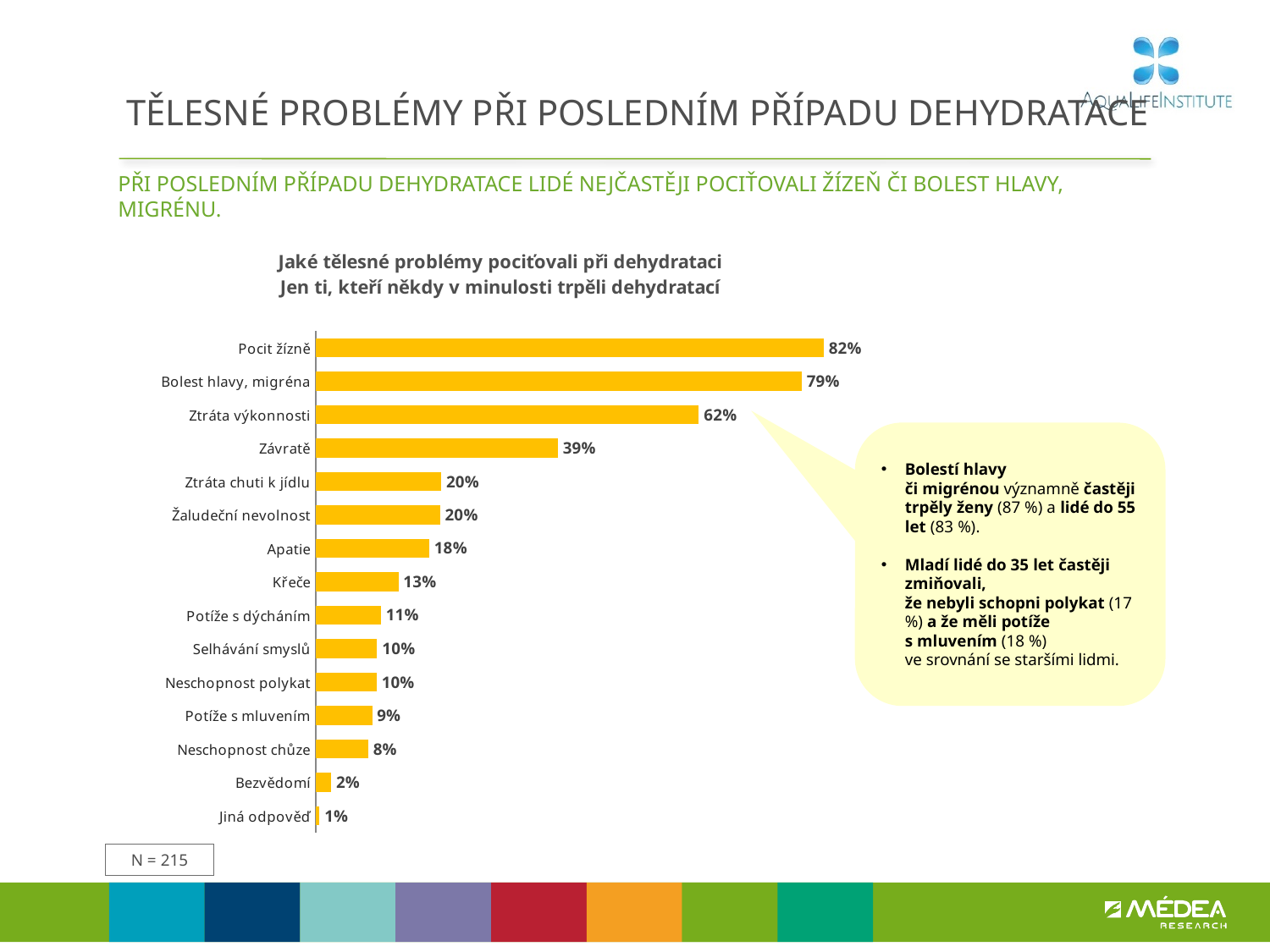
What is the value for Pocit žízně? 82% What is the value for Závratě? 39% Which category has the lowest value? Jiná odpověď What kind of chart is shown on the slide? Bar chart What is the difference between the values for Ztráta výkonnosti and Závratě? 23% Which is larger, the value for Křeče or the value for Potíže s dýcháním? Křeče What is the first line of the chart's title? Jaké tělesné problémy pociťovali při dehydrataci What is the value for Neschopnost chůze? 8% What is the difference between the values for Pocit žízně and Bolest hlavy, migréna? 3% Which category has the highest value? Pocit žízně How many categories are shown in the chart? 15 What is the value for Apatie? 18%